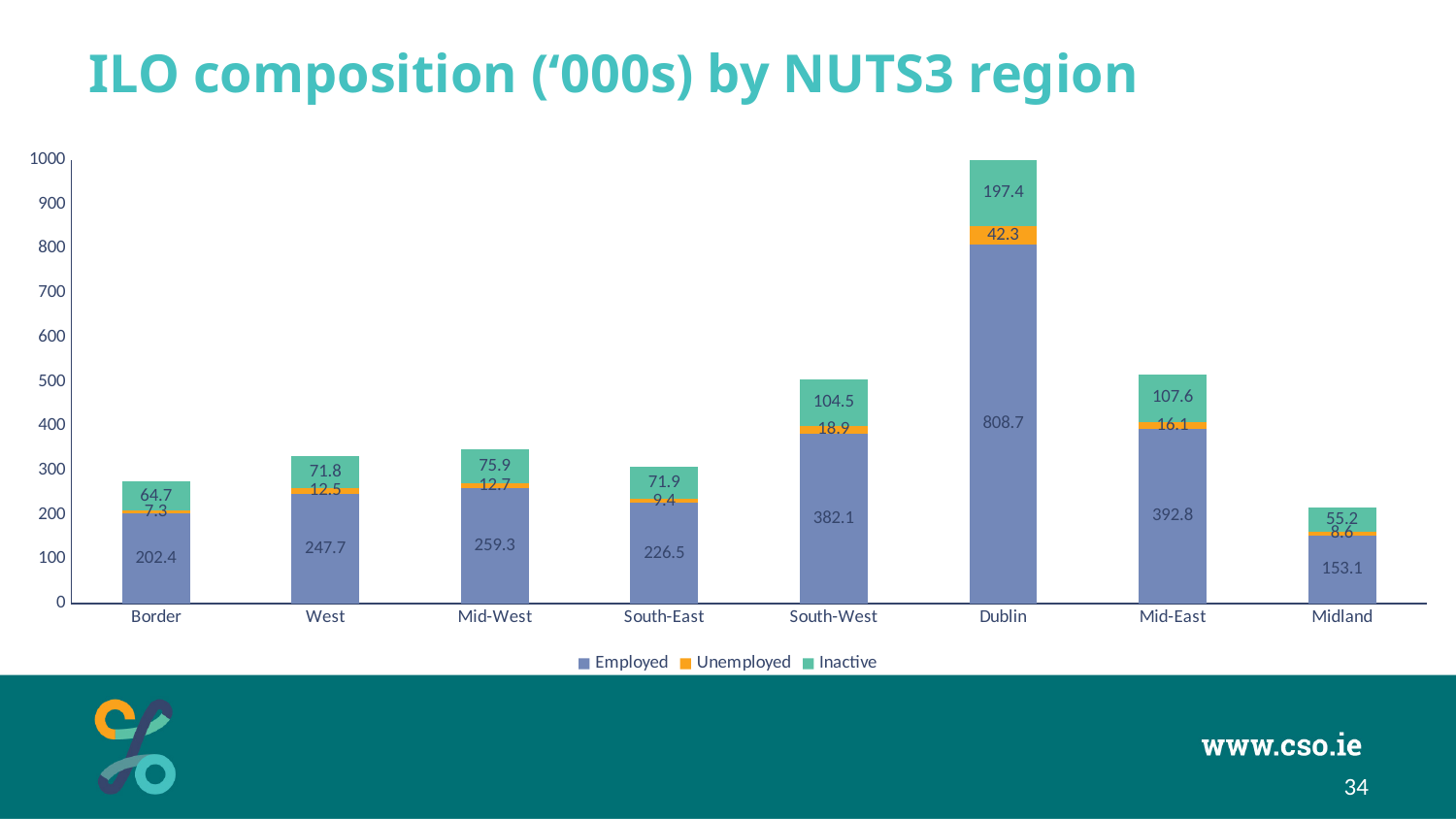
What is the total of the stacked bar for Border? 274.4 What is the Inactive value for Midland? 55.2 What is the difference between the Unemployed values for Dublin and Mid-East? 26.2 Which region has the larger Inactive value, West or Mid-West? Mid-West Which region has the highest Employed value? Dublin What is the Unemployed value for South-West? 18.9 How many regions are shown on the x axis? 8 What kind of chart is shown on the slide? Stacked bar chart Which region has the lowest Employed value? Midland How many series does the legend list? 3 What is the Employed value for Dublin? 808.7 What is the difference between the Employed values for Mid-East and South-West? 10.7